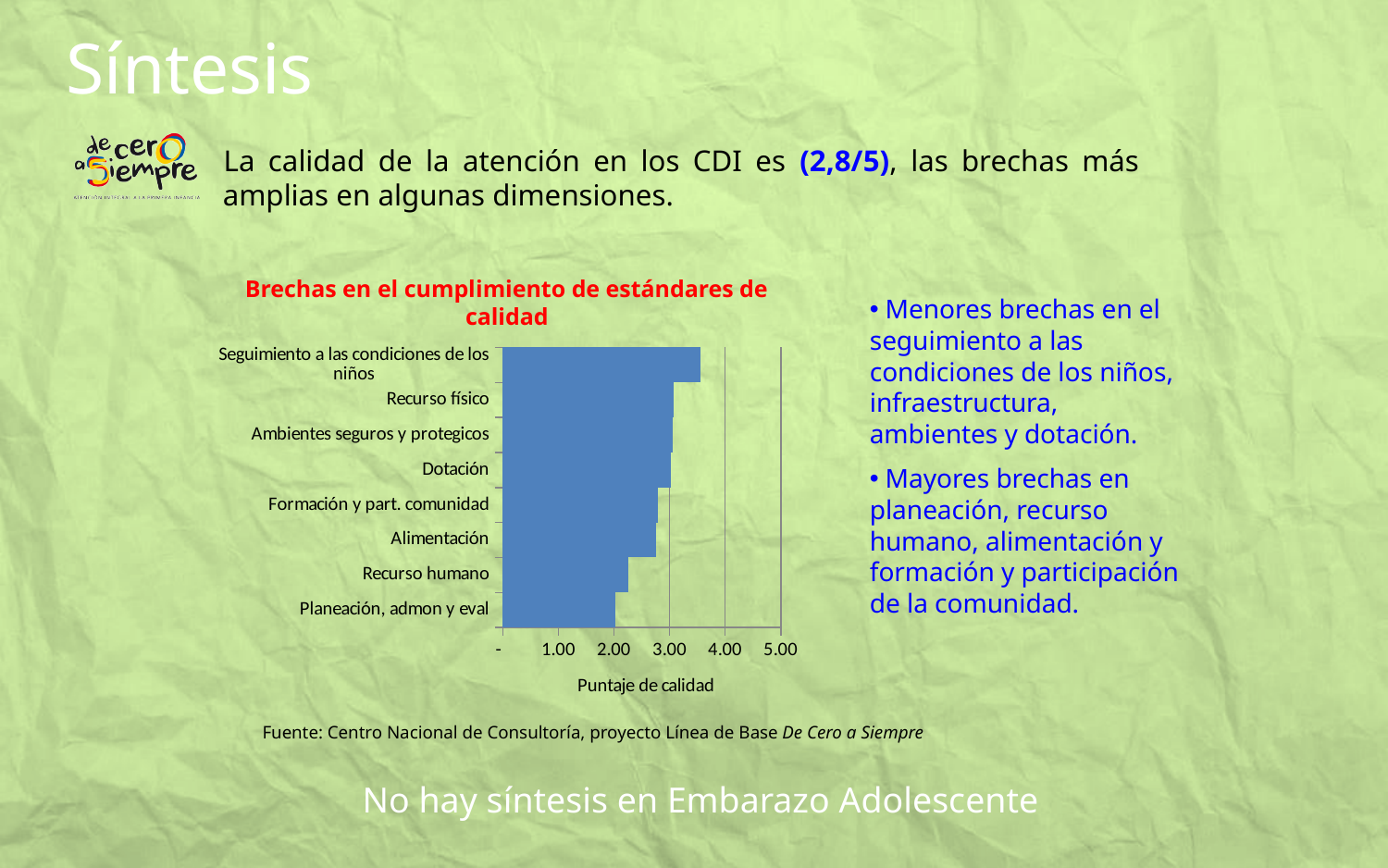
Is the value for Alimentación greater or less than 2.00? greater Is the value for Seguimiento a las condiciones de los niños greater or less than 3.00? greater How many categories are plotted in the chart? 8 What is the title of the chart? Brechas en el cumplimiento de estándares de calidad Is the value for Recurso humano greater or less than 3.00? less Which has a higher quality score, Alimentación or Recurso humano? Alimentación What is the label of the horizontal axis of the chart? Puntaje de calidad What type of chart is shown on the slide? Bar chart Which category has the lowest quality score in the chart? Planeación, admon y eval Which category has the highest quality score in the chart? Seguimiento a las condiciones de los niños